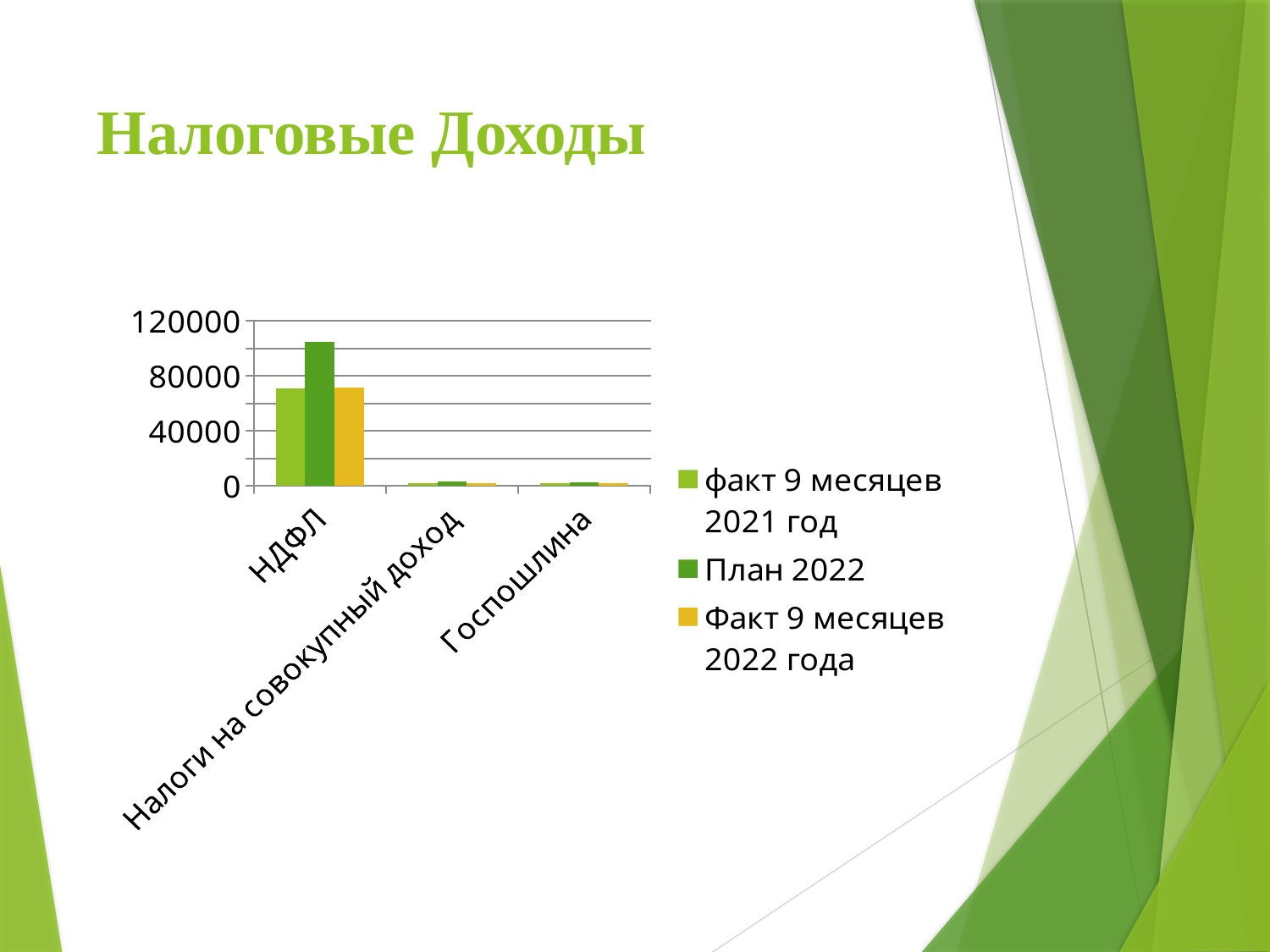
What is the highest value shown on the chart's vertical axis? 120000 Is the value of факт 9 месяцев 2021 год for НДФЛ greater or less than 80000? less How many series does the chart legend list? 3 Is the value of План 2022 for Госпошлина greater or less than 40000? less How many categories are shown on the x axis of the chart? 3 Which category has the highest values in the chart? НДФЛ What kind of chart is shown on the slide? bar chart For НДФЛ, which is larger: План 2022 or факт 9 месяцев 2021 год? План 2022 Is the value of Факт 9 месяцев 2022 года for НДФЛ greater or less than 40000? greater What is the title of the slide containing the chart? Налоговые Доходы Which series has the highest bar for НДФЛ? План 2022